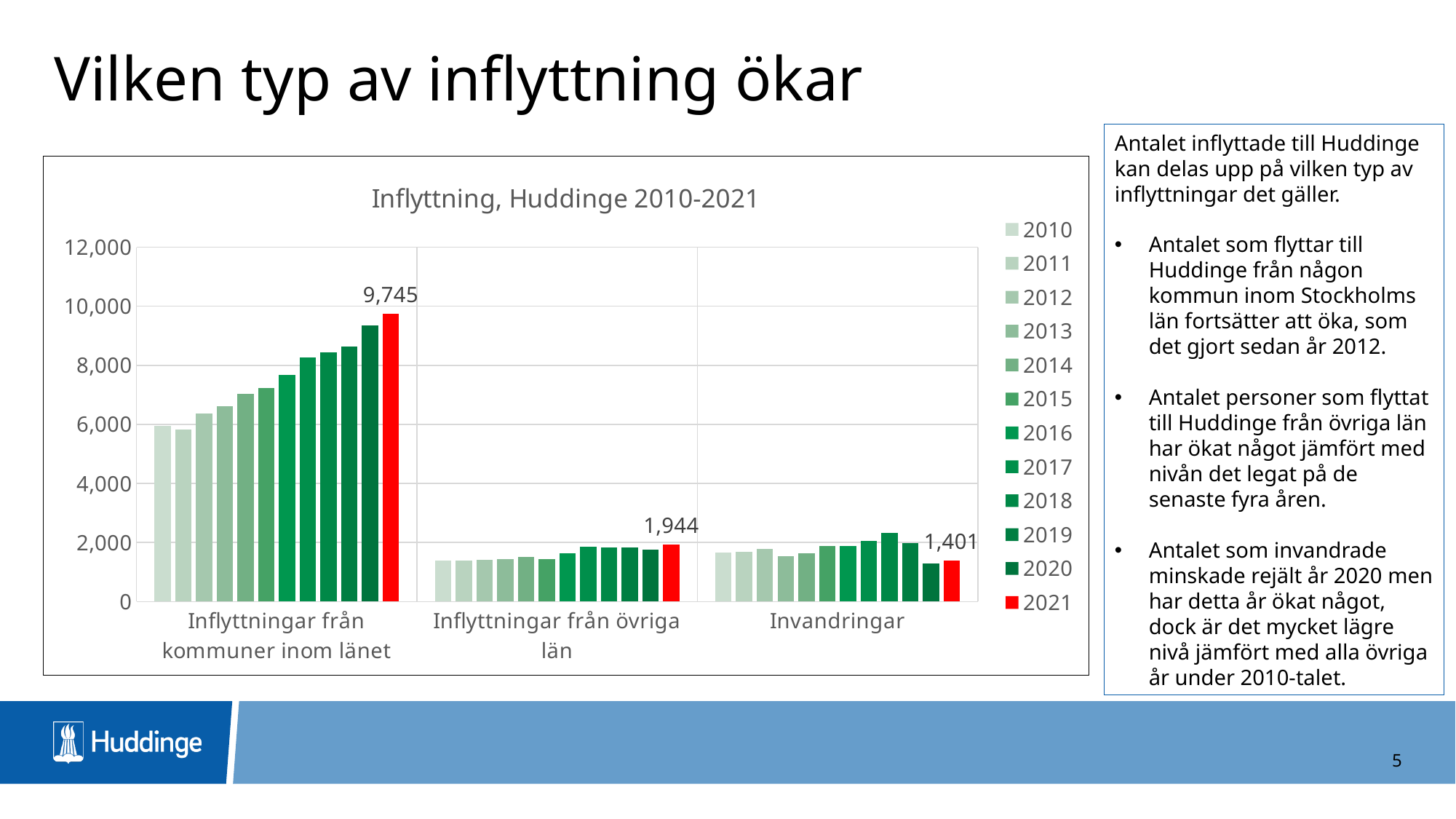
What is the difference between the 2021 values for "Inflyttningar från övriga län" and "Invandringar"? 543 What kind of chart is shown on the slide? bar chart In 2021, which is larger: "Inflyttningar från övriga län" or "Invandringar"? Inflyttningar från övriga län What is the 2021 value for "Invandringar"? 1,401 Is the 2020 value for "Invandringar" greater or less than 2,000? less Which category has the highest value in 2021? Inflyttningar från kommuner inom länet What is the difference between the 2021 values for "Inflyttningar från kommuner inom länet" and "Inflyttningar från övriga län"? 7,801 Is the 2010 value for "Inflyttningar från kommuner inom länet" greater or less than 4,000? greater How many series does the legend list? 12 What is the 2021 value for "Inflyttningar från kommuner inom länet"? 9,745 What is the 2021 value for "Inflyttningar från övriga län"? 1,944 How many categories are shown on the x axis? 3